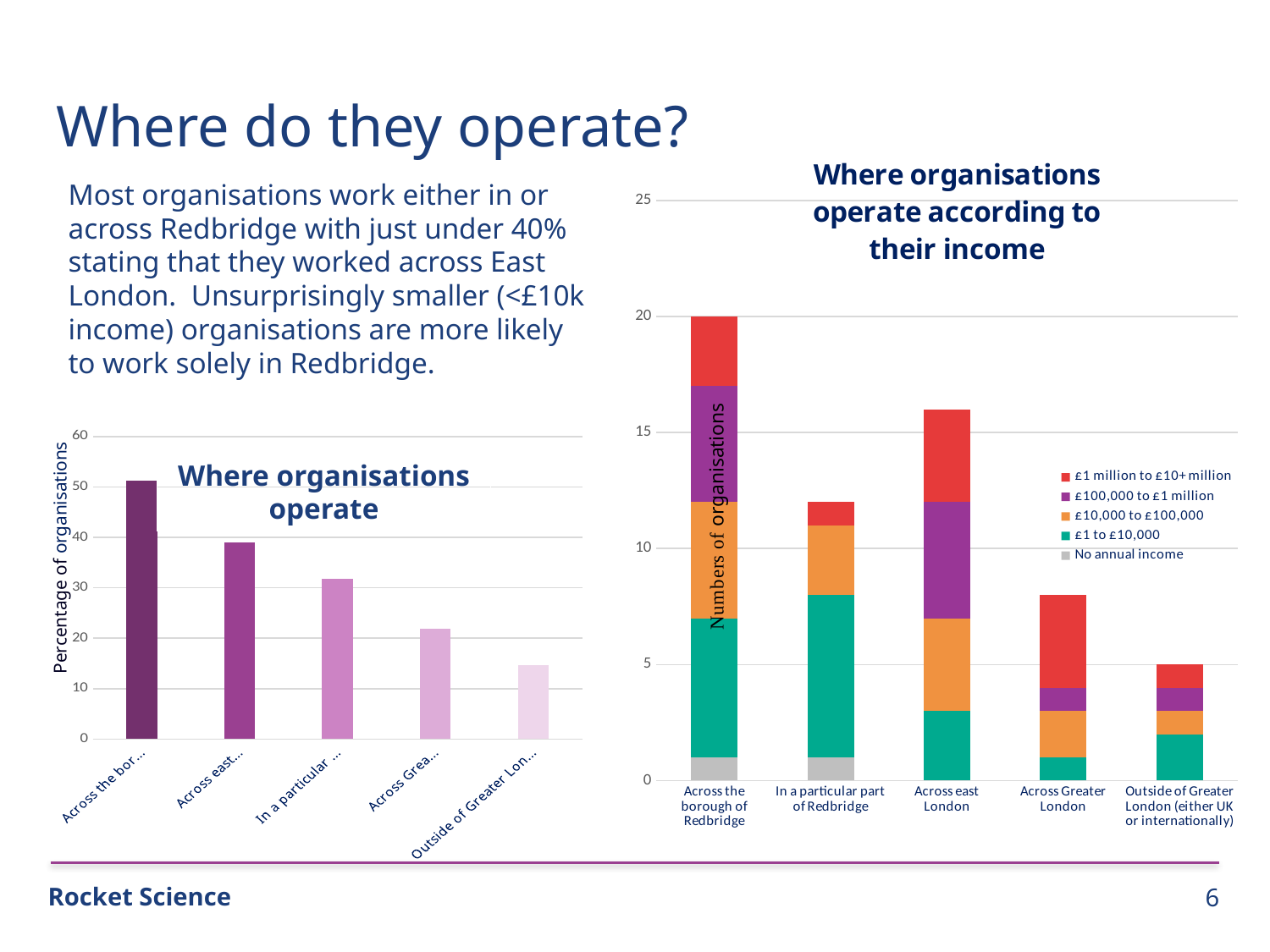
What kind of chart is the 'Where organisations operate according to their income' chart? stacked bar chart How many categories are shown on the x axis of the 'Where organisations operate according to their income' chart? 5 In the 'Where organisations operate' chart on the left, is the value of the first bar ('Across the bor...') greater or less than 50? greater In the 'Where organisations operate according to their income' chart, which category has the tallest stacked bar? Across the borough of Redbridge In the 'Where organisations operate' chart on the left, do the bar values rise or fall from left to right along the x axis? fall How many series does the legend of the 'Where organisations operate according to their income' chart list? 5 What kind of chart is the 'Where organisations operate' chart on the left? bar chart In the 'Where organisations operate according to their income' chart, which category has the shortest stacked bar? Outside of Greater London (either UK or internationally) In the 'Where organisations operate according to their income' chart, which colour represents '£1 million to £10+ million'? red In the 'Where organisations operate according to their income' chart, which is larger: the total for 'In a particular part of Redbridge' or the total for 'Across east London'? Across east London In the 'Where organisations operate according to their income' chart, is the total for 'Across east London' greater or less than 15? greater In the 'Where organisations operate according to their income' chart, is the total for 'Across Greater London' greater or less than 10? less